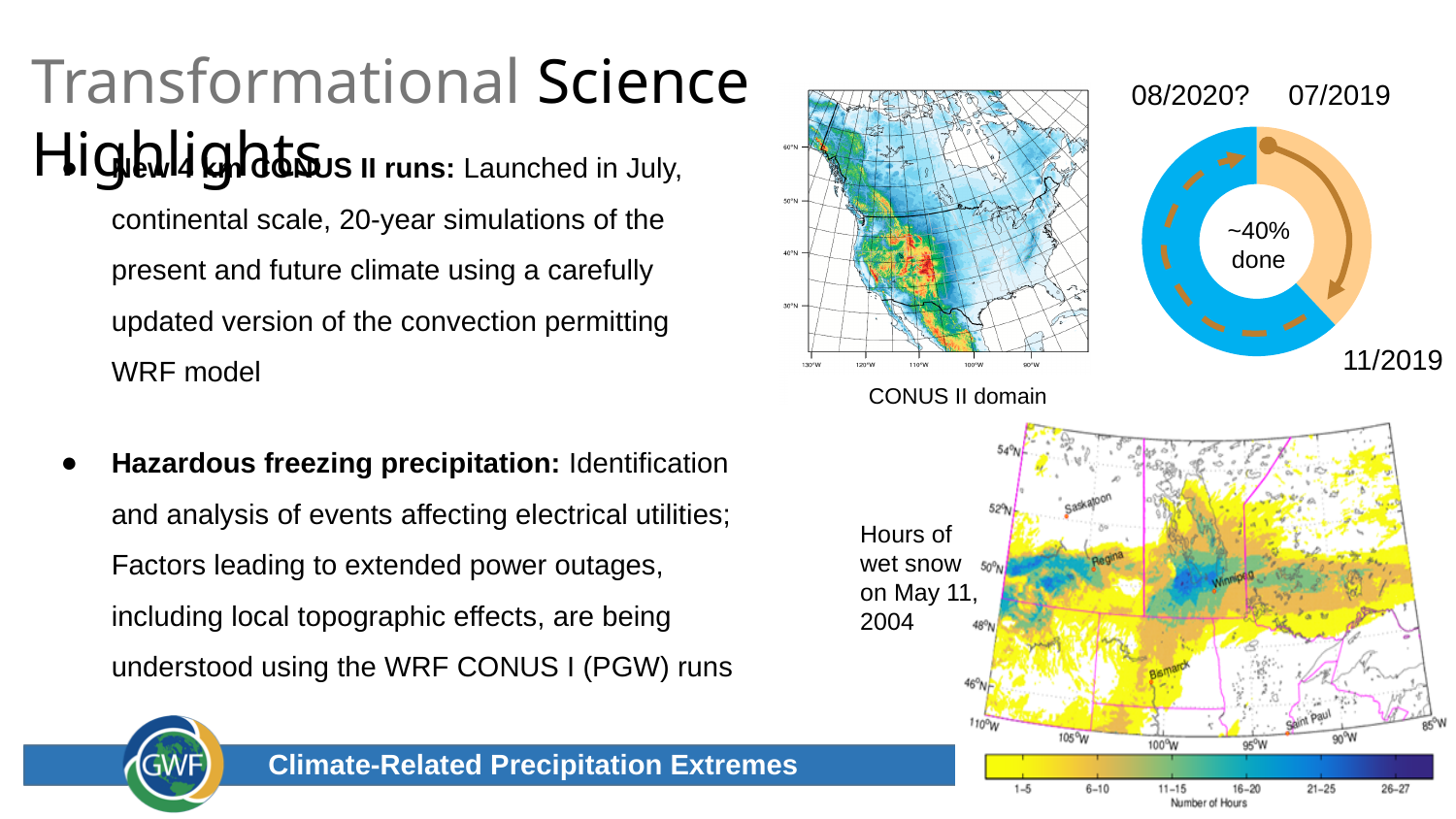
In the donut chart, which segment is larger, the blue one or the orange one? blue Is the share of the donut chart marked as done greater or less than 50%? less How many segments does the donut chart in the top right have? 2 Which date label on the donut chart is followed by a question mark? 08/2020? What text is printed in the centre of the donut chart? ~40% done What date label appears at the bottom right of the donut chart? 11/2019 What kind of chart is shown in the top right of the slide, next to the CONUS II domain map? donut (pie) chart